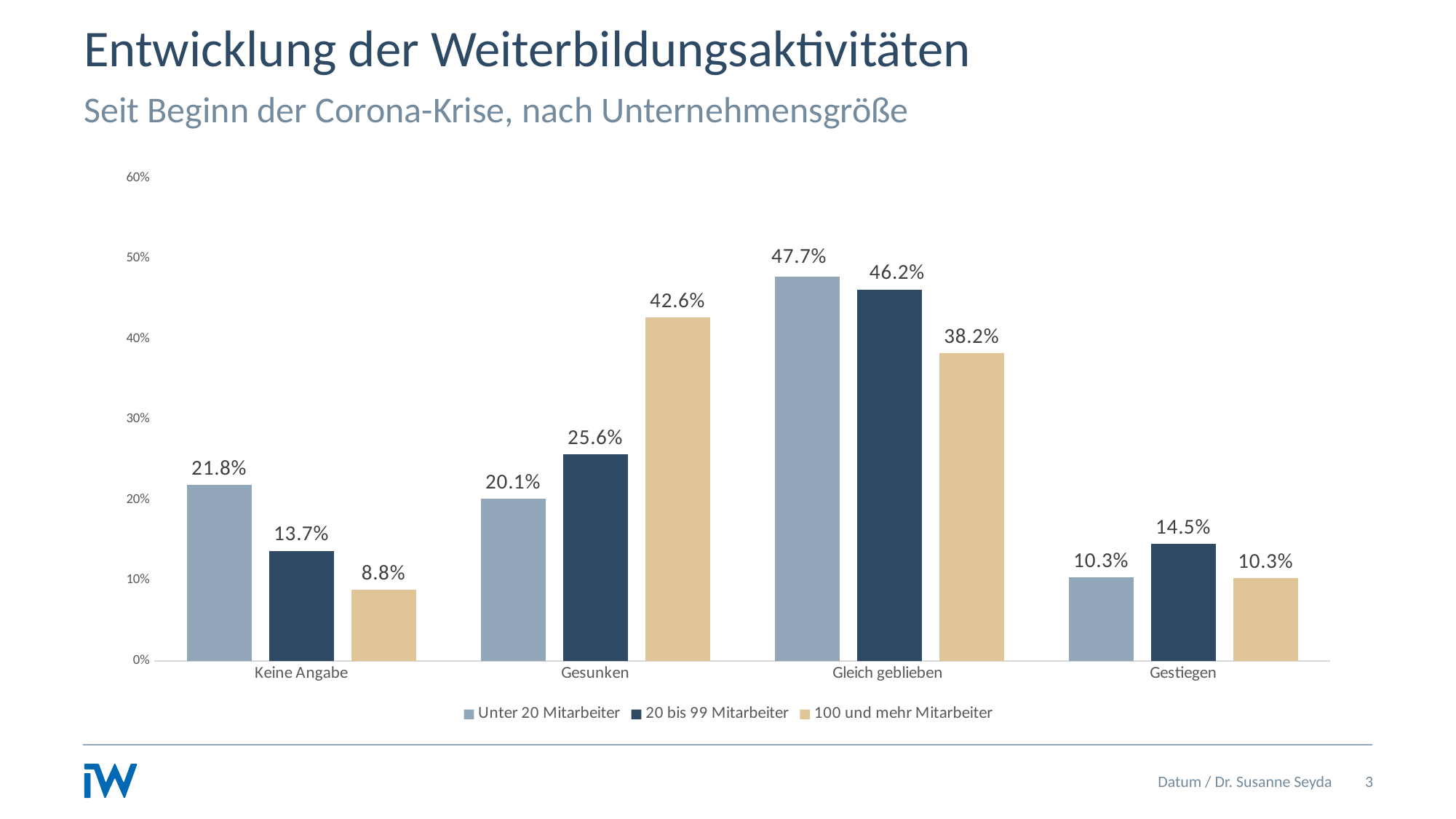
Which series has the lowest value in the 'Keine Angabe' category? 100 und mehr Mitarbeiter What is the difference between the '100 und mehr Mitarbeiter' and 'Unter 20 Mitarbeiter' values in the 'Gesunken' category? 22.5% What is the subtitle of the slide? Seit Beginn der Corona-Krise, nach Unternehmensgröße What kind of chart is shown on the slide? Bar chart What is the value for '20 bis 99 Mitarbeiter' in the 'Keine Angabe' category? 13.7% What is the value for 'Unter 20 Mitarbeiter' in the 'Gleich geblieben' category? 47.7% In the 'Gestiegen' category, which is larger: 'Unter 20 Mitarbeiter' or '20 bis 99 Mitarbeiter'? 20 bis 99 Mitarbeiter How many categories are shown on the x axis? 4 Is the value for '100 und mehr Mitarbeiter' in 'Gleich geblieben' greater or less than 40%? less How many series does the legend list? 3 What is the value for '100 und mehr Mitarbeiter' in the 'Gesunken' category? 42.6% Which category has the highest value for the 'Unter 20 Mitarbeiter' series? Gleich geblieben